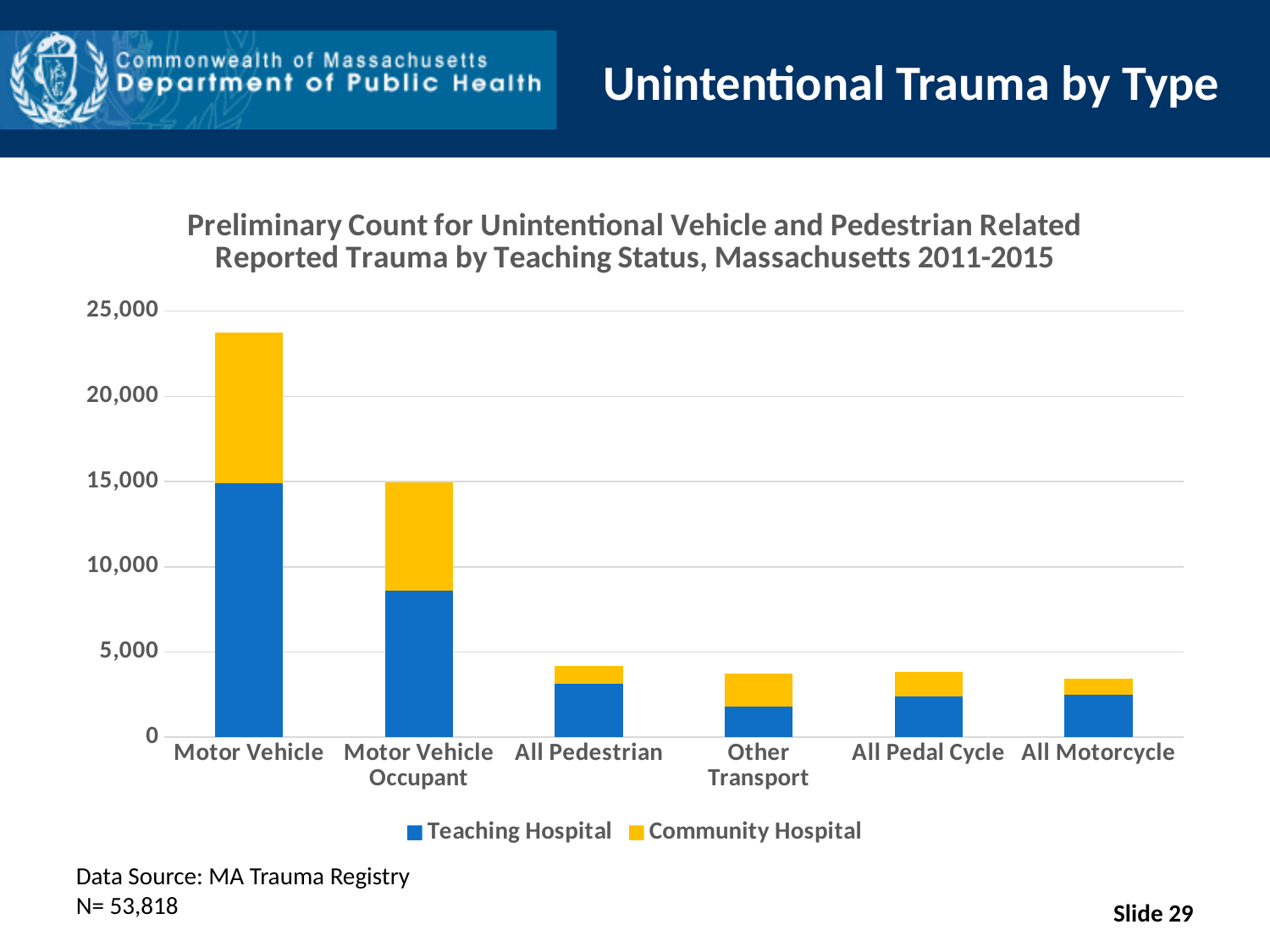
How many series does the chart legend list? 2 Is the total value for Motor Vehicle greater or less than 20,000? greater Is the Teaching Hospital value for Motor Vehicle Occupant greater or less than 10,000? less Is the Teaching Hospital value for Motor Vehicle greater or less than 10,000? greater How many categories are shown on the x axis of the chart? 6 Which has a larger Teaching Hospital count, All Pedestrian or Other Transport? All Pedestrian Which has a larger total count, Motor Vehicle or Motor Vehicle Occupant? Motor Vehicle Which category has the lowest Teaching Hospital count? Other Transport Which category has the highest total count in the chart? Motor Vehicle What kind of chart is shown on the slide? Stacked bar chart Which colour represents Community Hospital in the chart? Yellow